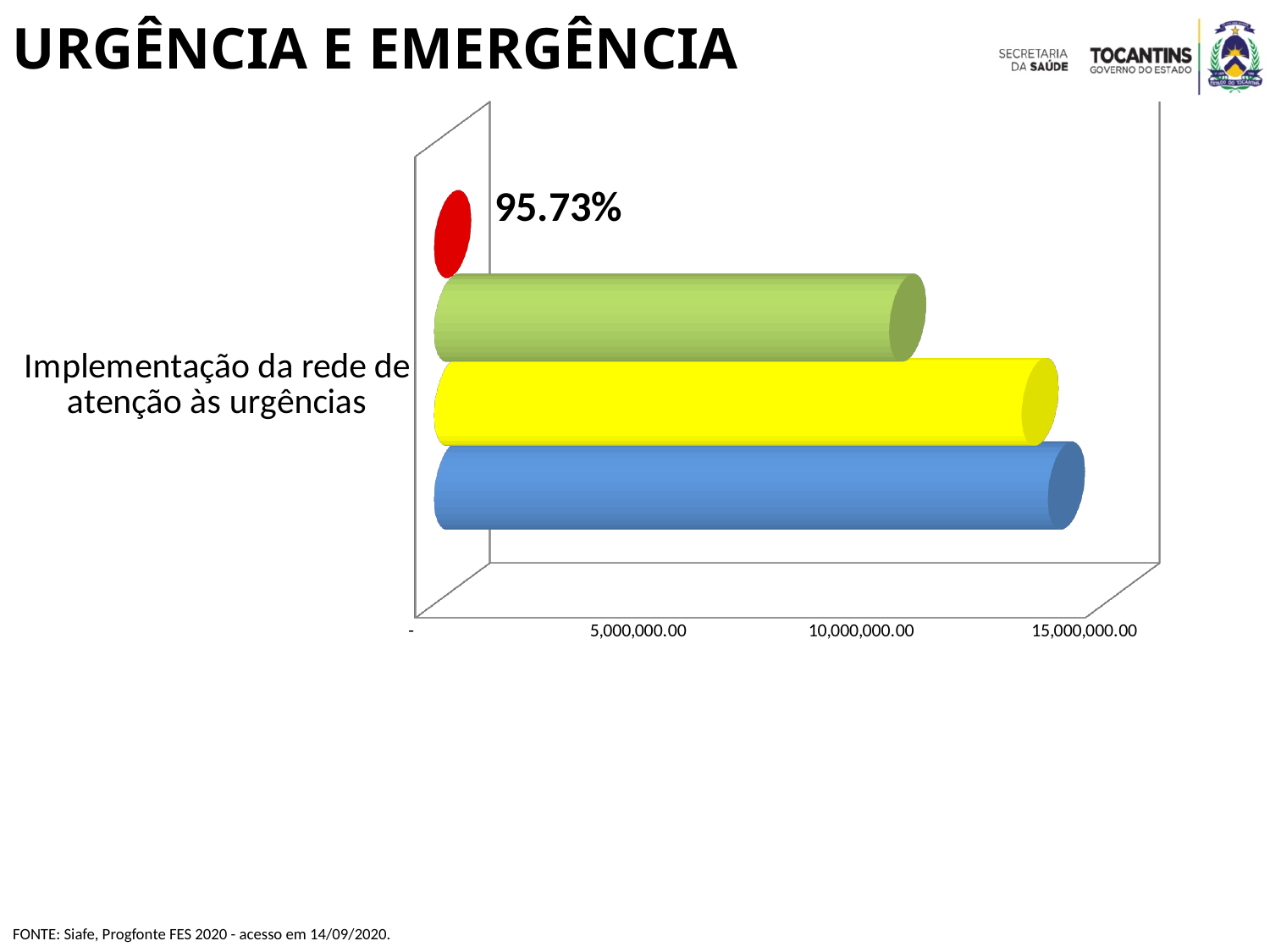
What is the category label shown on the chart? Implementação da rede de atenção às urgências Which coloured bar is the shortest in the chart? green How many categories are shown on the vertical axis of the chart? 1 Which coloured bar is the longest in the chart? blue Is the value of the yellow bar greater or less than 10,000,000.00? greater How many bars are plotted for the category 'Implementação da rede de atenção às urgências'? 3 Which is larger, the value of the green bar or the value of the yellow bar? yellow bar What percentage value is printed as a data label on the chart? 95.73% What kind of chart is shown on the slide? bar chart What is the title shown at the top of the slide above the chart? URGÊNCIA E EMERGÊNCIA Is the value of the green bar greater or less than 5,000,000.00? greater